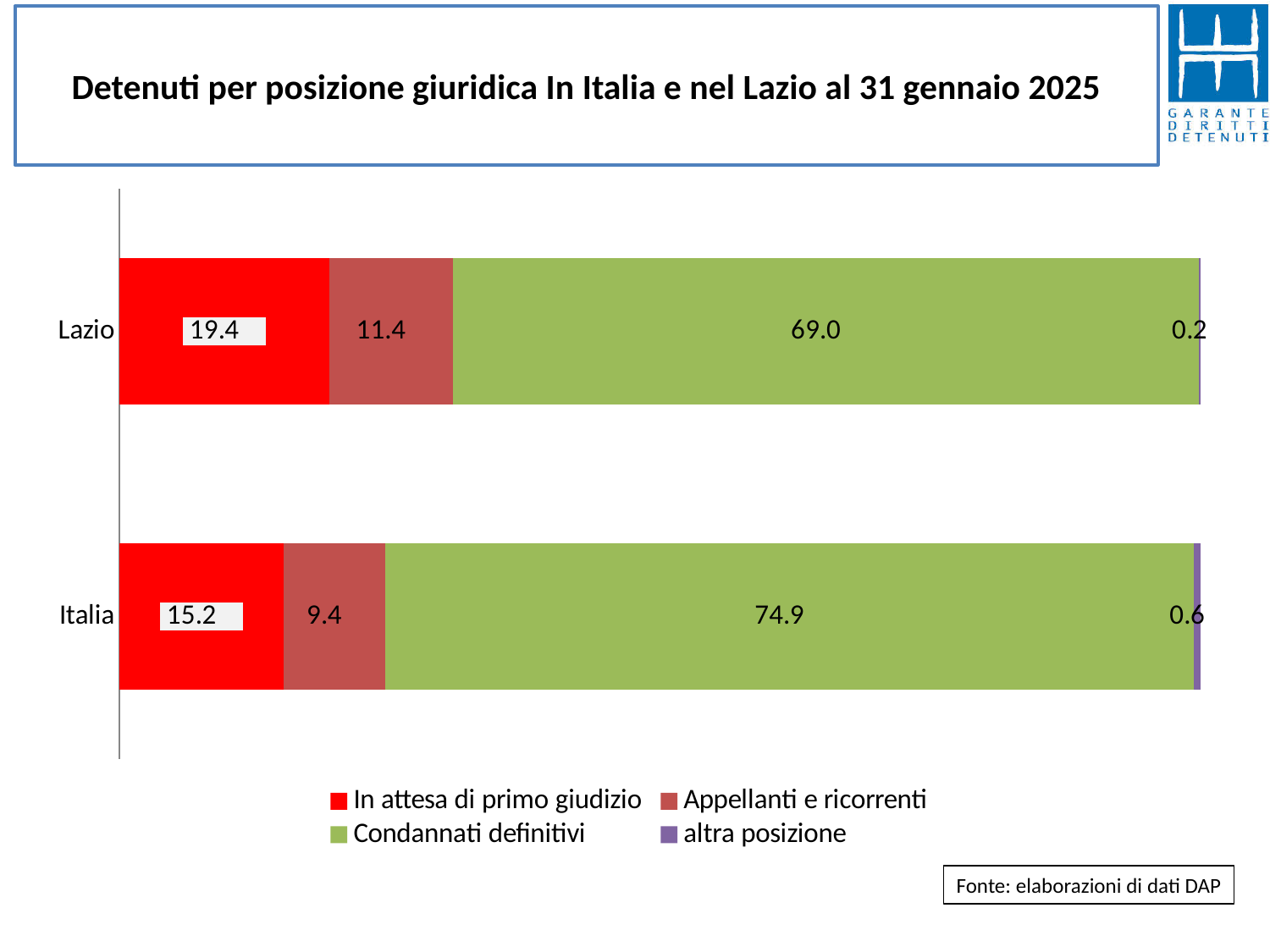
What is the total of the Lazio stacked bar? 100.0 What is the value for 'Appellanti e ricorrenti' for Lazio? 11.4 What is the difference between the 'Condannati definitivi' values for Italia and Lazio? 5.9 How many series does the legend list? 4 What is the value for 'Condannati definitivi' for Italia? 74.9 Which is larger: 'In attesa di primo giudizio' for Lazio or for Italia? Lazio Which series has the smallest value in the Italia bar? altra posizione What type of chart is shown on the slide? Stacked bar chart Which series has the largest value in the Lazio bar? Condannati definitivi What is the value for 'altra posizione' for Italia? 0.6 How many categories (bars) are shown in the chart? 2 What is the value for 'In attesa di primo giudizio' for Lazio? 19.4